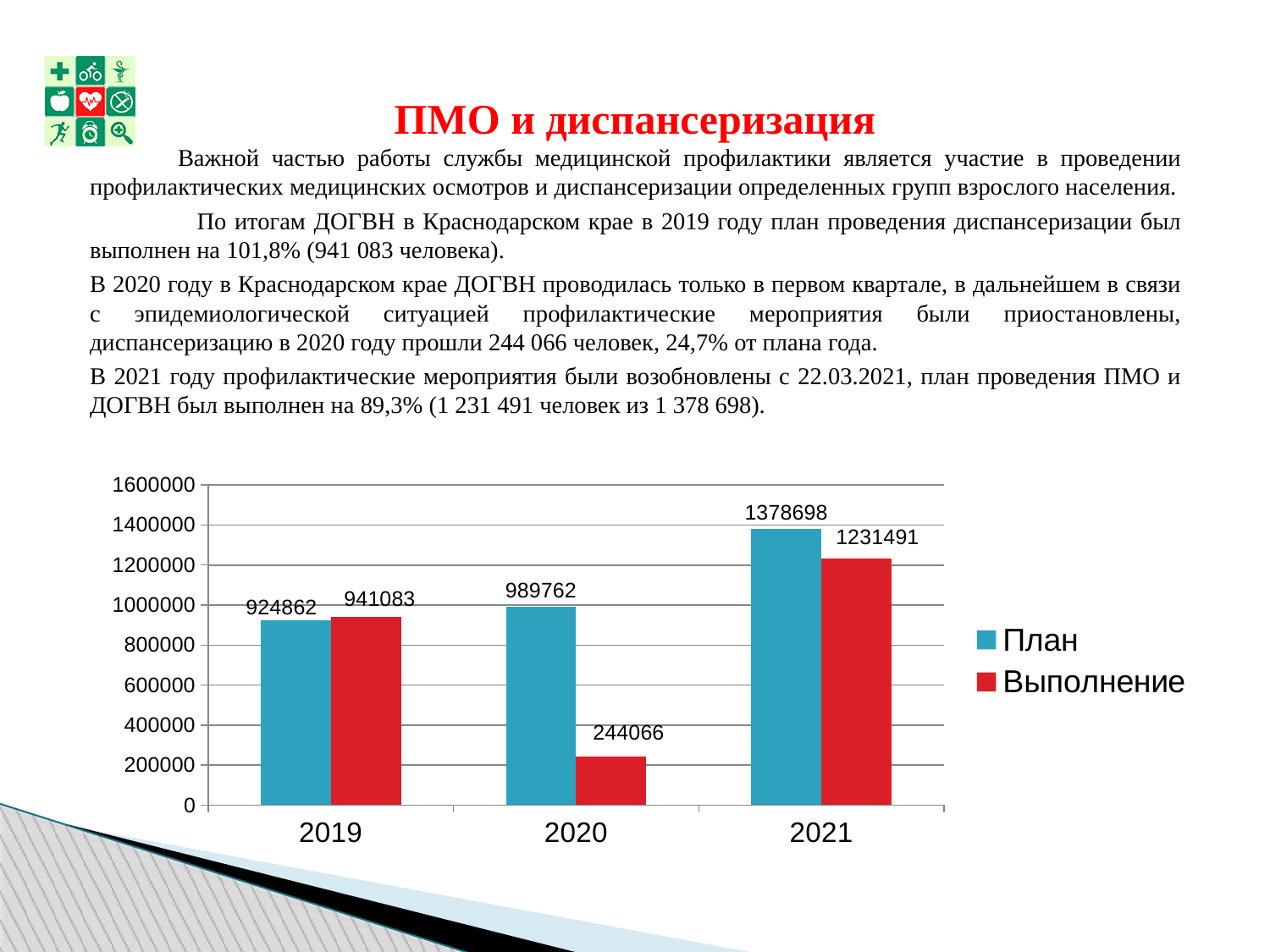
Is the Выполнение value for 2020 greater or less than 400000? less What is the difference between План and Выполнение in 2021? 147207 Which is larger in 2019, План or Выполнение? Выполнение How many years are shown on the x axis? 3 What is the value of Выполнение for 2019? 941083 Which year has the lowest Выполнение value? 2020 What kind of chart is shown on the slide? bar chart Which year has the highest План value? 2021 What is the difference between План and Выполнение in 2020? 745696 What is the value of Выполнение for 2021? 1231491 How many series does the legend list? 2 What is the value of План for 2020? 989762